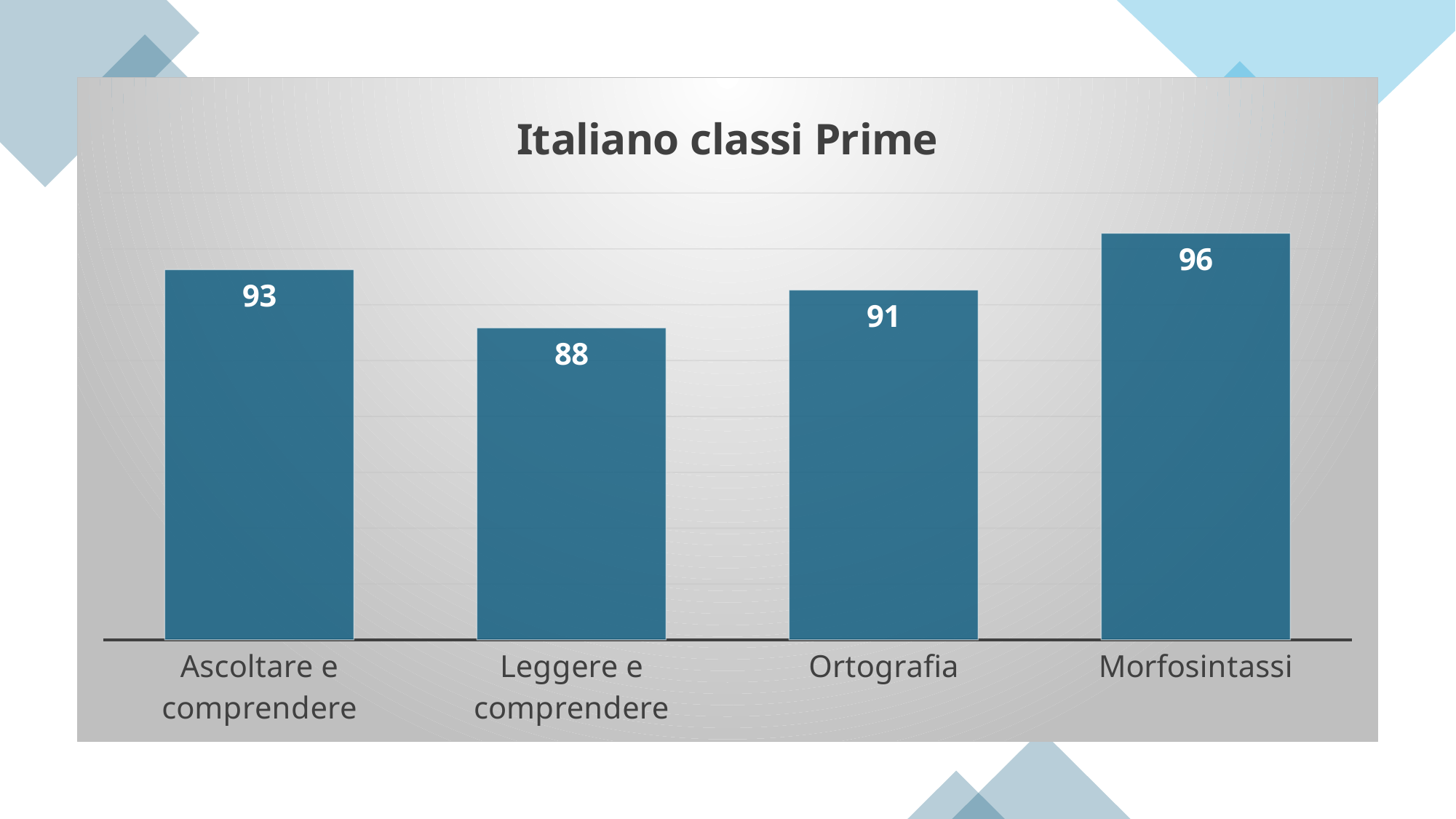
Which category has the highest value? Morfosintassi What is the value for Leggere e comprendere? 88 Which category has the lowest value? Leggere e comprendere What is the difference between the values for Ascoltare e comprendere and Ortografia? 2 What is the value for Ascoltare e comprendere? 93 Which is larger, the value for Ascoltare e comprendere or the value for Ortografia? Ascoltare e comprendere What is the value for Ortografia? 91 What kind of chart is shown on the slide? Bar chart What is the title of the chart? Italiano classi Prime What is the value for Morfosintassi? 96 How many categories are shown in the chart? 4 What is the difference between the values for Morfosintassi and Leggere e comprendere? 8